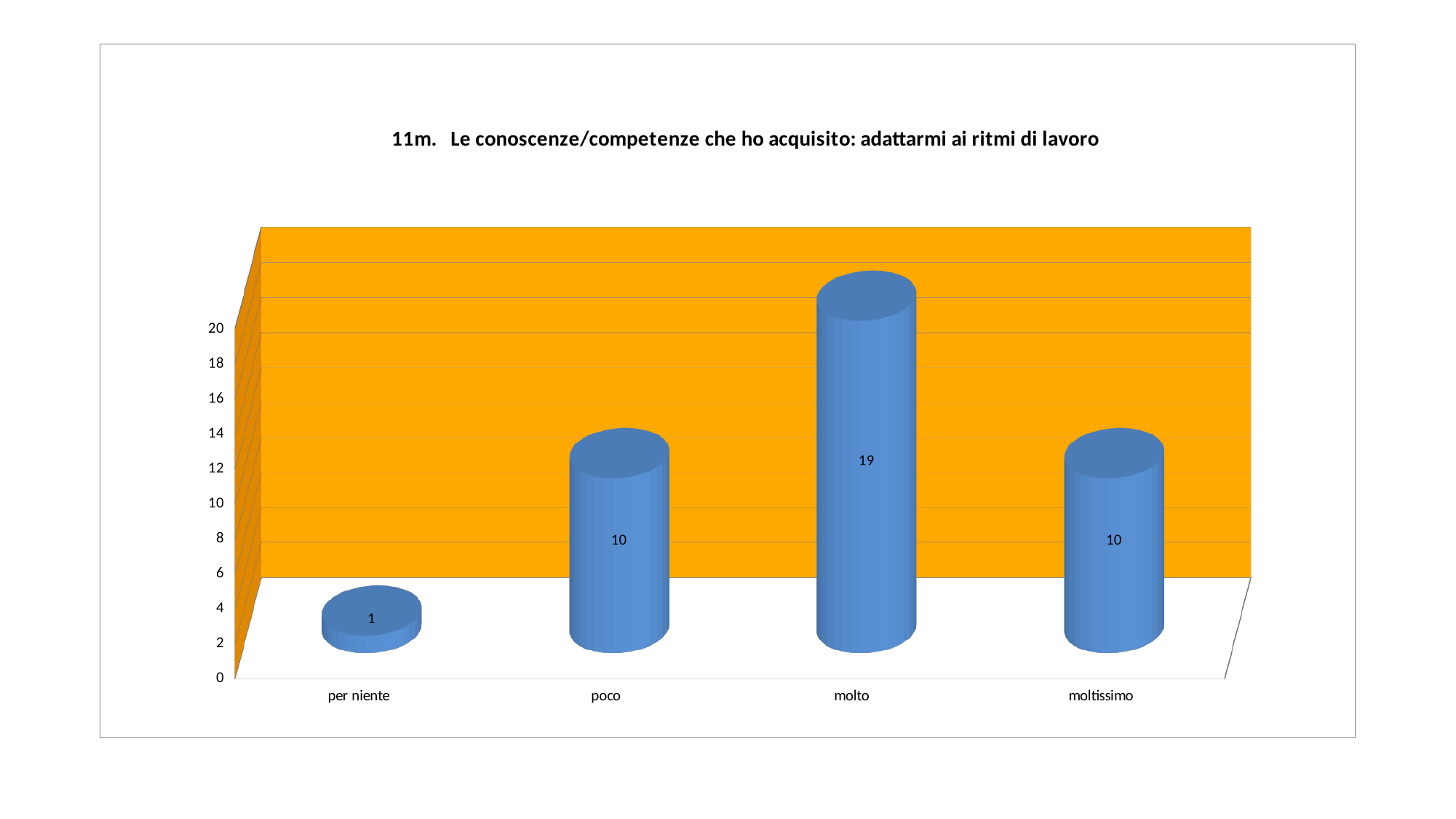
What is the value for "molto"? 19 What is the value for "poco"? 10 What is the difference between the values for "moltissimo" and "per niente"? 9 What is the difference between the values for "molto" and "poco"? 9 How many categories are shown on the x axis? 4 Which is larger, the value for "molto" or the value for "moltissimo"? molto What is the title of the chart? 11m. Le conoscenze/competenze che ho acquisito: adattarmi ai ritmi di lavoro What kind of chart is this? bar chart Which category has the lowest value? per niente What is the value for "moltissimo"? 10 What is the value for "per niente"? 1 Which category has the highest value? molto